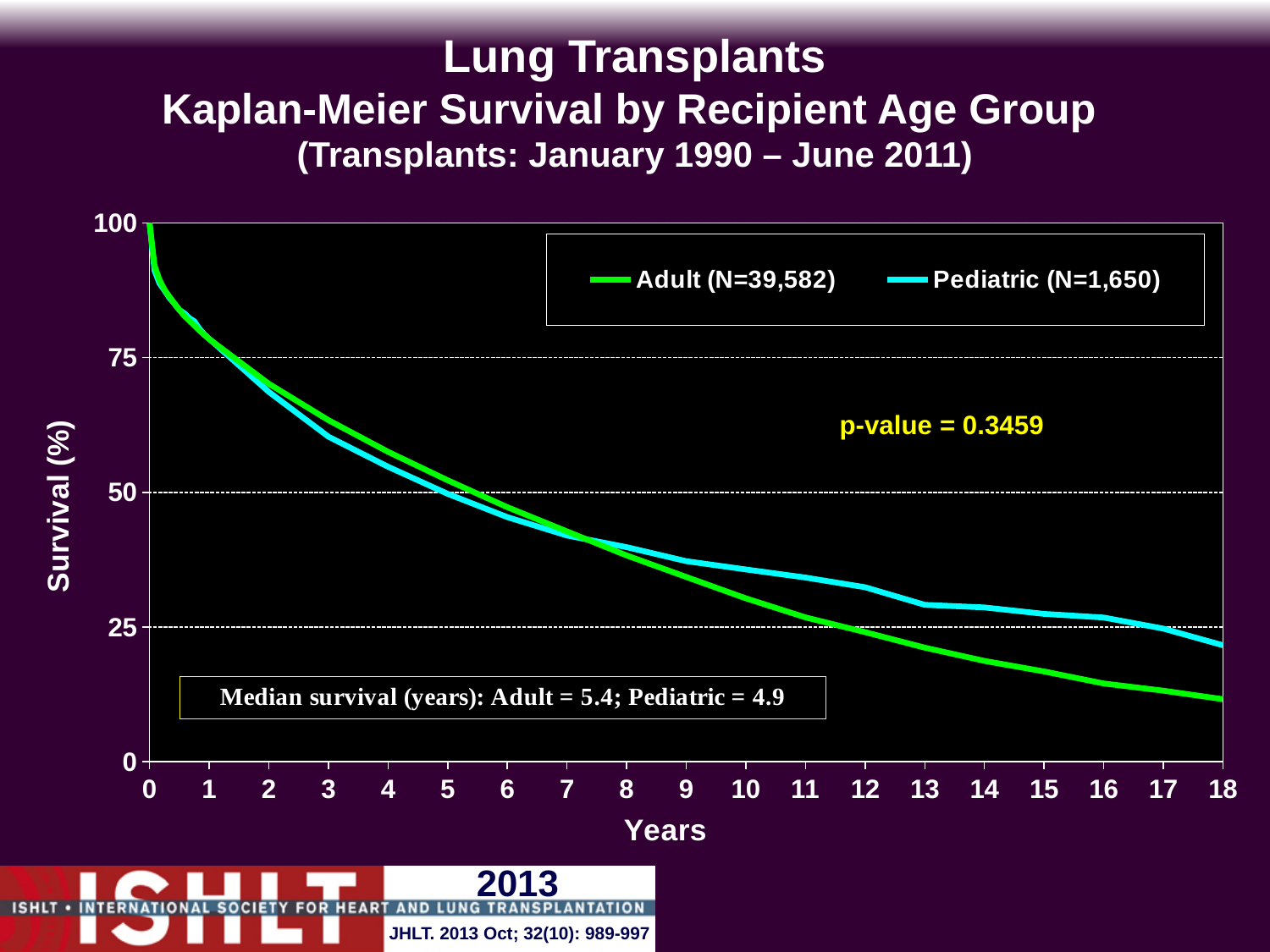
Do the survival curves rise or fall as the years increase? fall Is the Pediatric survival at 10 years greater or less than 25? greater How many series does the legend list? 2 What is the median survival in years for the Adult group? 5.4 Is the Adult survival at 18 years greater or less than 25? less At 15 years, which curve shows higher survival, Adult or Pediatric? Pediatric Which group has the longer median survival, Adult or Pediatric? Adult What p-value is printed on the chart? 0.3459 What kind of chart is shown on the slide? line chart What is the difference in median survival (years) between the Adult and Pediatric groups? 0.5 What is the median survival in years for the Pediatric group? 4.9 Is the Adult survival at 10 years greater or less than 50? less